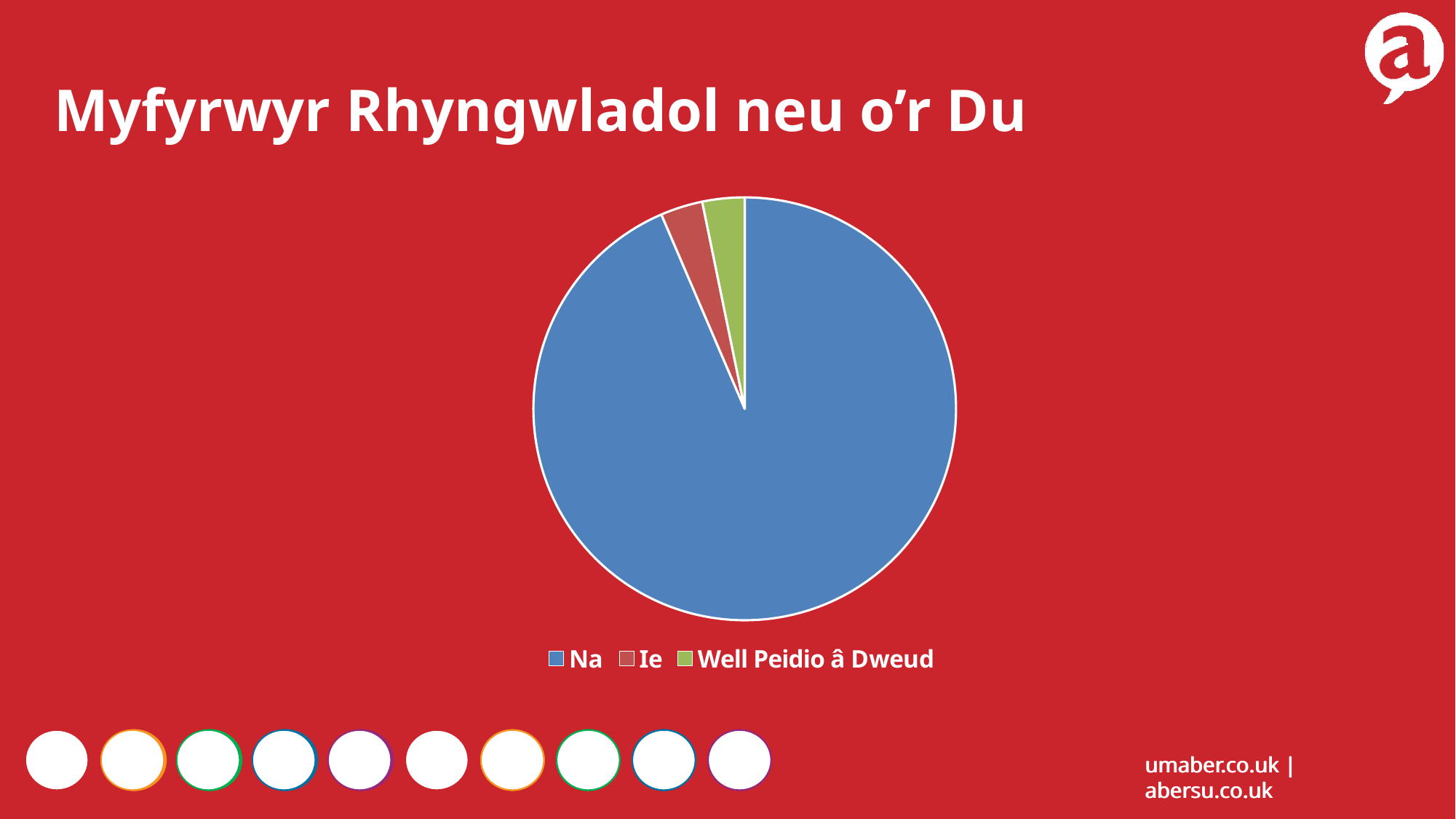
Which category has the largest slice of the pie? Na How many slices does the pie chart have? 3 What kind of chart is shown on the slide? pie chart How many entries does the legend list? 3 Which is larger, the slice for Na or the slice for Ie? Na What colour is the slice for Well Peidio â Dweud? green What is the title of the slide containing the pie chart? Myfyrwyr Rhyngwladol neu o’r Du Which is larger, the slice for Na or the slice for Well Peidio â Dweud? Na